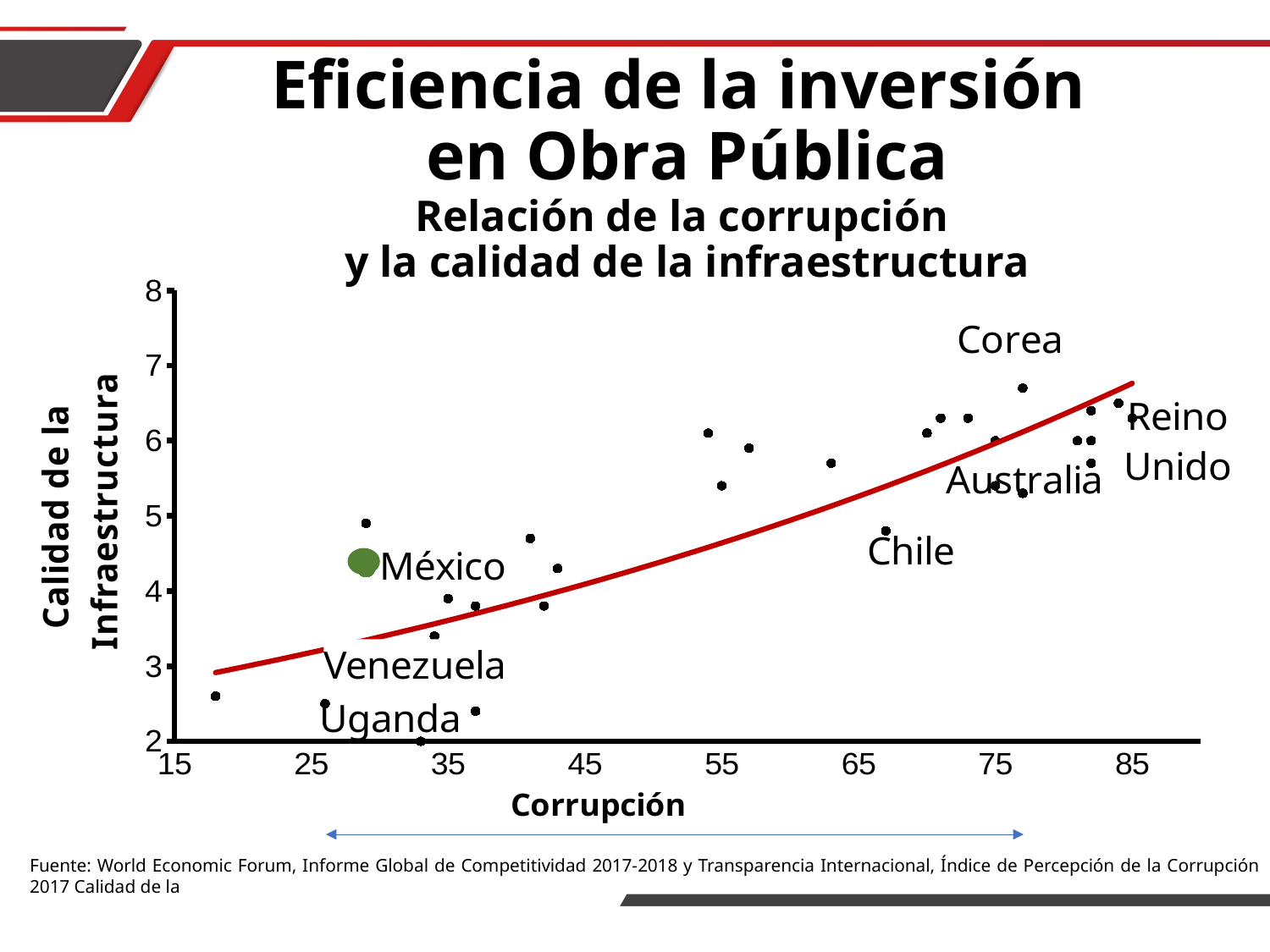
Is the infrastructure quality value for Uganda greater or less than 3? less Is the infrastructure quality value for México greater or less than 4? greater Is the corruption value for Reino Unido greater or less than 75? greater Among the labeled countries, which has the lowest infrastructure quality value? Uganda What is the label of the horizontal axis of the chart? Corrupción Which has a higher infrastructure quality value, Corea or Chile? Corea What is the label of the vertical axis of the chart? Calidad de la Infraestructura What kind of chart is shown on the slide? Scatter chart Does the red trend line rise or fall as the corruption value increases along the x axis? Rises